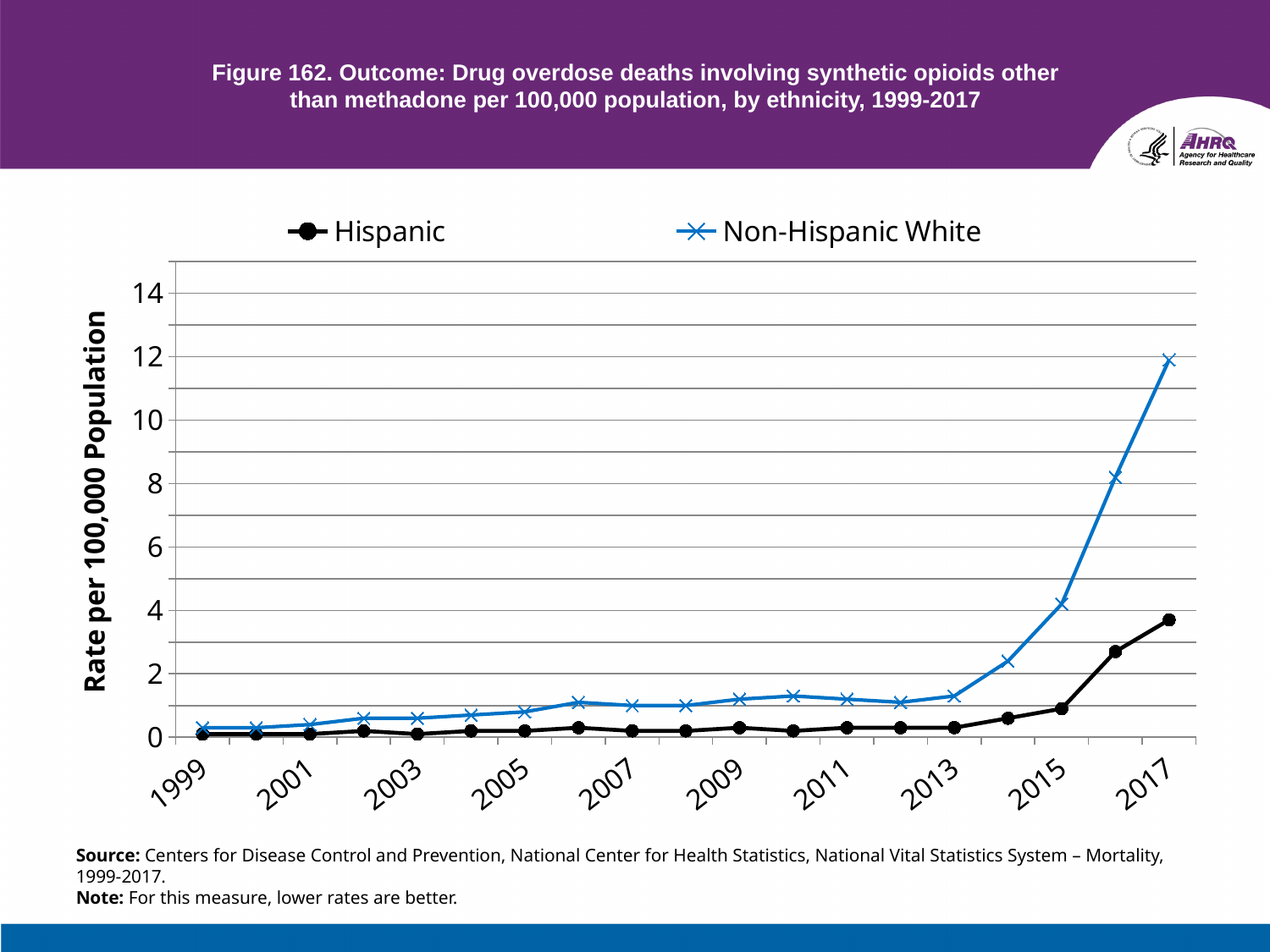
Is the value for Hispanic in 2013 greater or less than 2? less Is the value for Non-Hispanic White in 2015 greater or less than 2? greater How many series does the legend list? 2 In which year does the Non-Hispanic White series reach its highest value? 2017 What kind of chart is shown on the slide? line chart Do the values for Non-Hispanic White rise or fall between 2013 and 2017? rise Which two series are shown in the legend? Hispanic and Non-Hispanic White Is the value for Non-Hispanic White in 2016 greater or less than 6? greater In 2017, which series has the higher value, Hispanic or Non-Hispanic White? Non-Hispanic White What is the label on the vertical axis? Rate per 100,000 Population